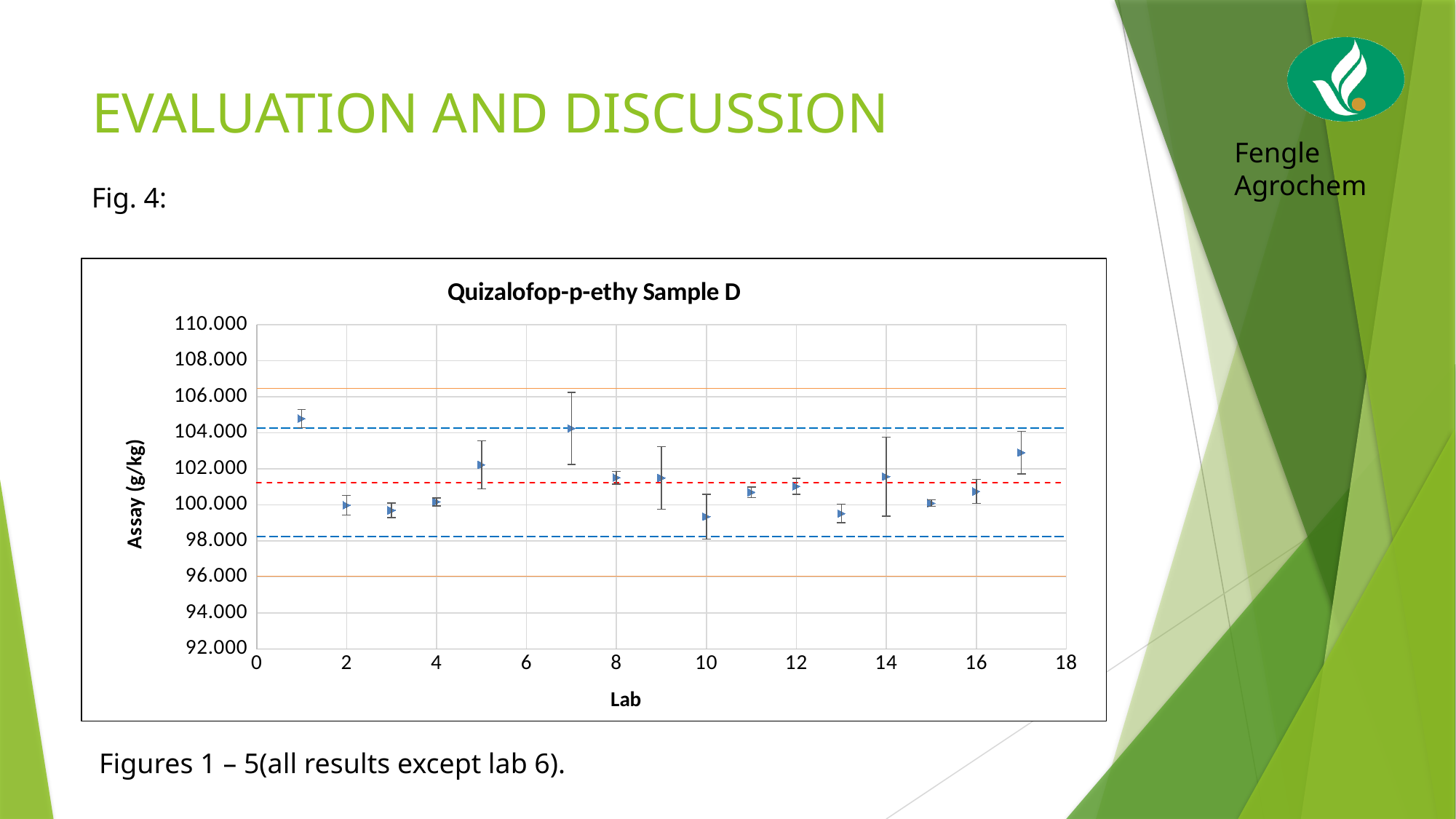
Which lab has the highest assay value? Lab 1 How many labs have data points plotted on the chart? 16 Which has the larger assay value, lab 1 or lab 2? Lab 1 Is the value for lab 10 greater or less than 100.000? less What is the label of the y axis? Assay (g/kg) Which has the larger assay value, lab 17 or lab 13? Lab 17 Is the value for lab 17 greater or less than 102.000? greater What kind of chart is shown on the slide? scatter chart Which has the larger assay value, lab 5 or lab 10? Lab 5 Is the value for lab 7 greater or less than 102.000? greater What is the title of the chart? Quizalofop-p-ethy Sample D